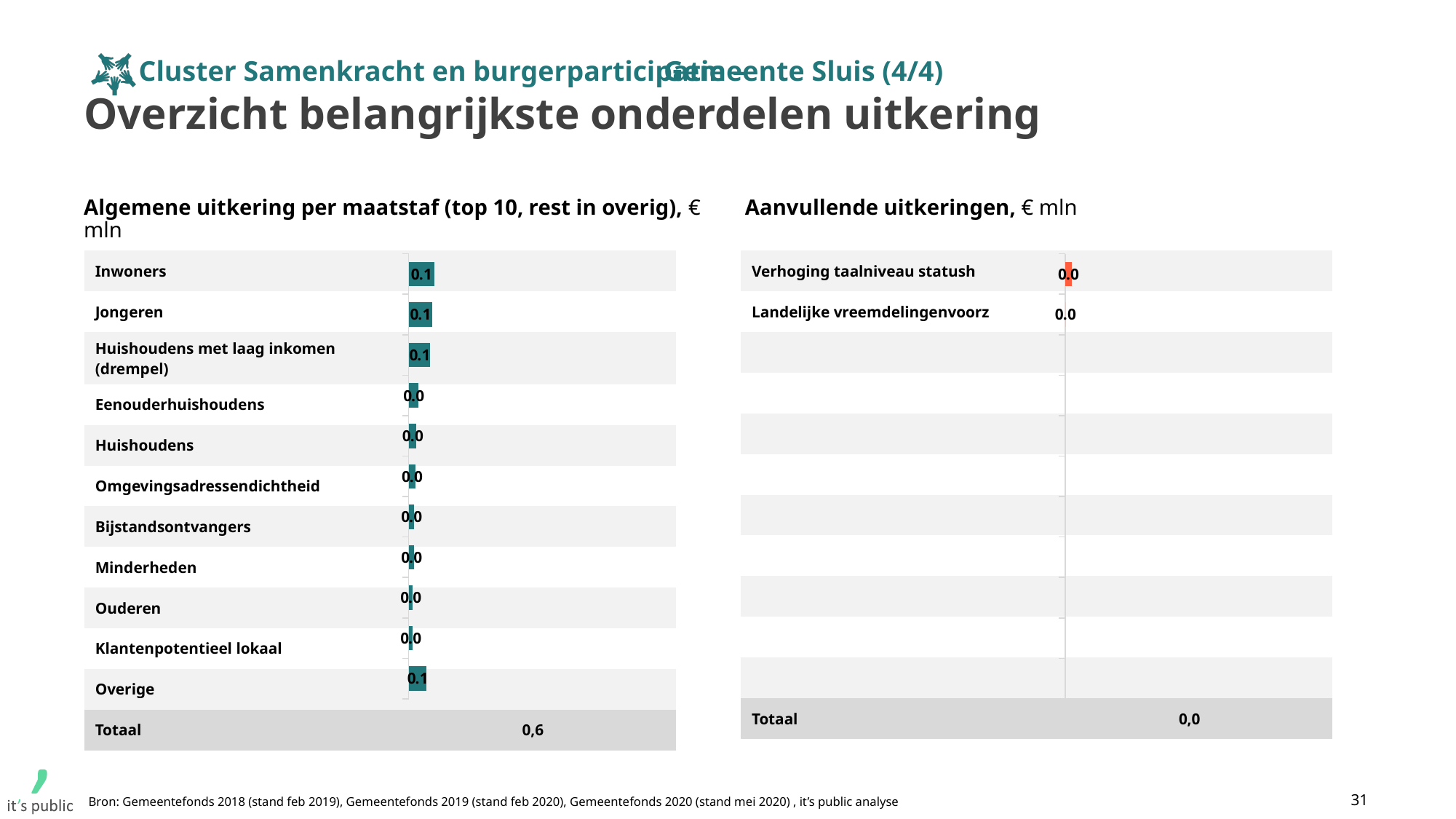
In the 'Algemene uitkering per maatstaf' chart, what is the value for Inwoners? 0.1 In the 'Aanvullende uitkeringen' chart, what is the value shown for Totaal? 0,0 In the 'Algemene uitkering per maatstaf' chart, which is larger: the value for Inwoners or the value for Ouderen? Inwoners In the 'Aanvullende uitkeringen' chart, how many categories have labels? 2 In the 'Algemene uitkering per maatstaf' chart, what is the value for Jongeren? 0.1 In the 'Algemene uitkering per maatstaf' chart, what is the value for Ouderen? 0.0 In the 'Algemene uitkering per maatstaf' chart, what is the value shown for Totaal? 0,6 In the 'Algemene uitkering per maatstaf' chart, what is the value for Overige? 0.1 What kind of chart is the 'Algemene uitkering per maatstaf' chart? Bar chart In the 'Algemene uitkering per maatstaf' chart, how many categories are plotted (excluding the Totaal row)? 11 In the 'Aanvullende uitkeringen' chart, what is the value for Landelijke vreemdelingenvoorz? 0.0 In the 'Aanvullende uitkeringen' chart, what is the value for Verhoging taalniveau statush? 0.0